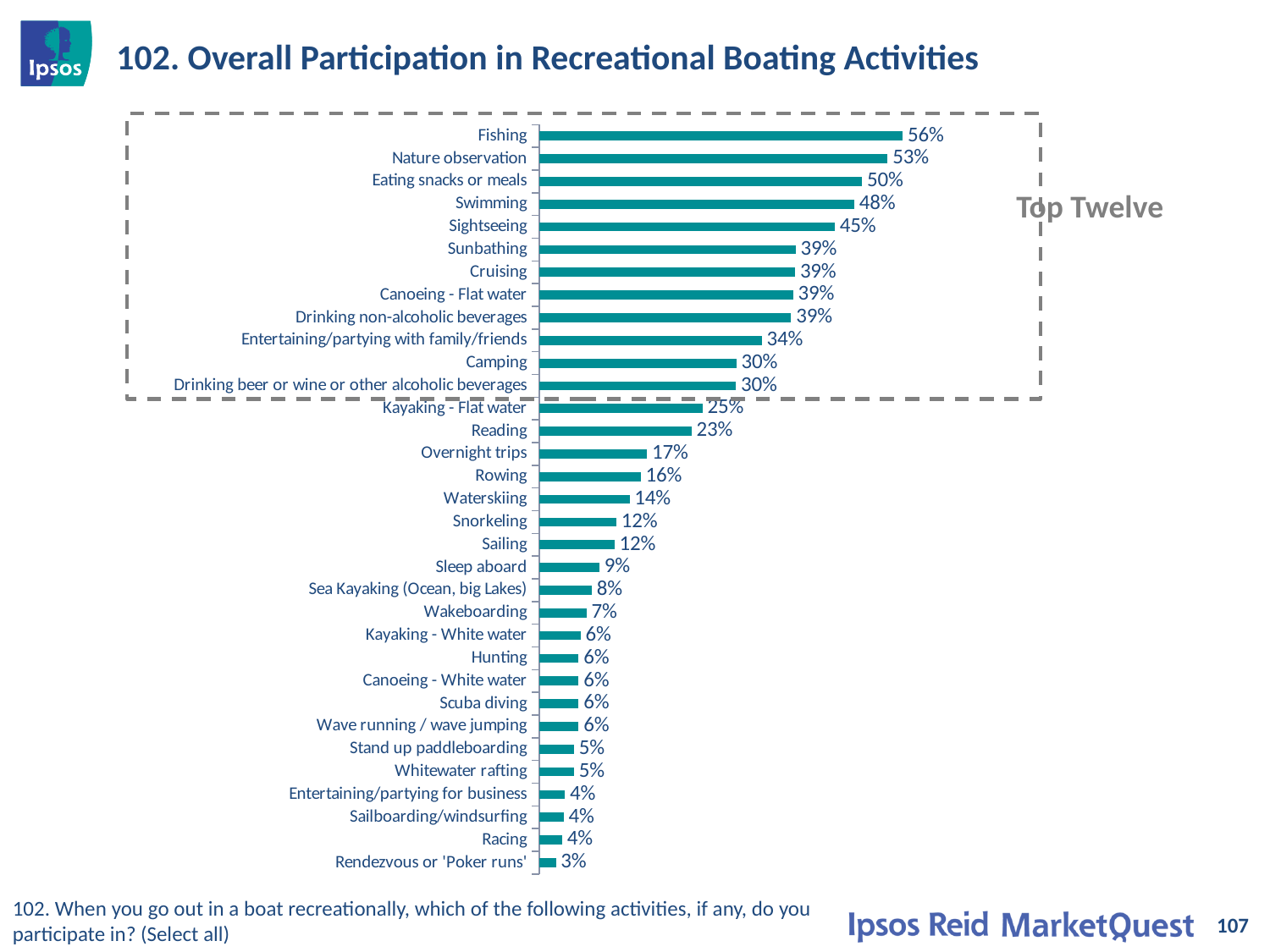
Which is larger, the value for Overnight trips or the value for Waterskiing? Overnight trips What label appears next to the dashed box around the first twelve bars? Top Twelve What is the value for Swimming? 48% How many activities are shown in the chart? 33 What is the value for Sea Kayaking (Ocean, big Lakes)? 8% What is the value for Reading? 23% What kind of chart is shown on the slide? Bar chart What is the difference between the values for Sightseeing and Camping? 15% Which activity has the lowest participation? Rendezvous or 'Poker runs' Which activity has the highest participation? Fishing What is the difference between the values for Fishing and Nature observation? 3% What is the value for Fishing? 56%